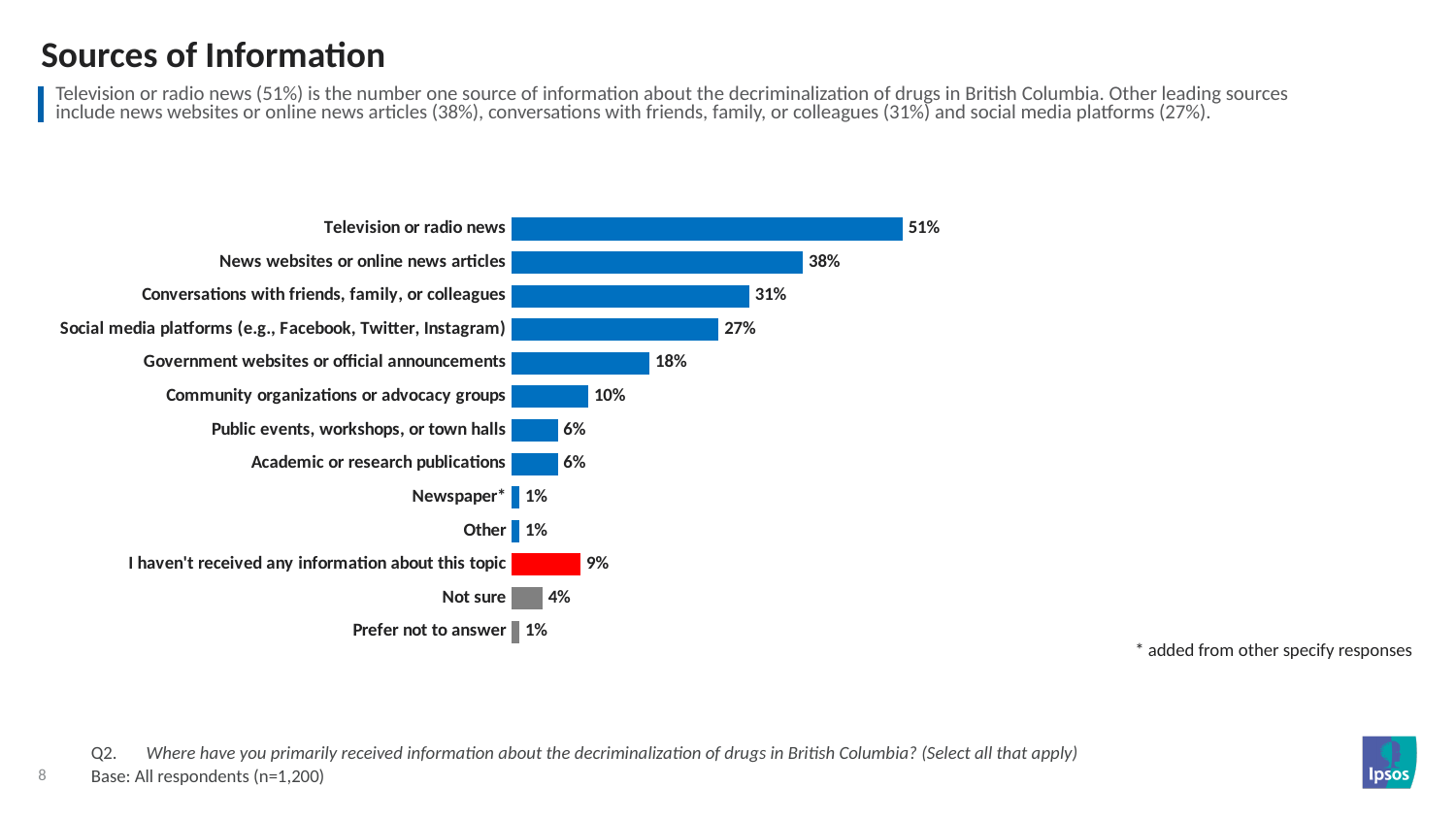
What type of chart is shown on the slide? Bar chart What percentage of respondents cited television or radio news as a source of information? 51% What is the value for 'Not sure'? 4% What is the value for government websites or official announcements? 18% What percentage of respondents said they haven't received any information about this topic? 9% What is the difference between the values for news websites or online news articles and social media platforms? 11% Which source of information has the highest percentage? Television or radio news What is the difference between television or radio news and conversations with friends, family, or colleagues? 20% Which bar is coloured red? I haven't received any information about this topic Which is larger: the value for community organizations or advocacy groups or the value for 'I haven't received any information about this topic'? Community organizations or advocacy groups Which is larger: the value for government websites or official announcements or the value for social media platforms? Social media platforms How many categories are shown in the chart? 13